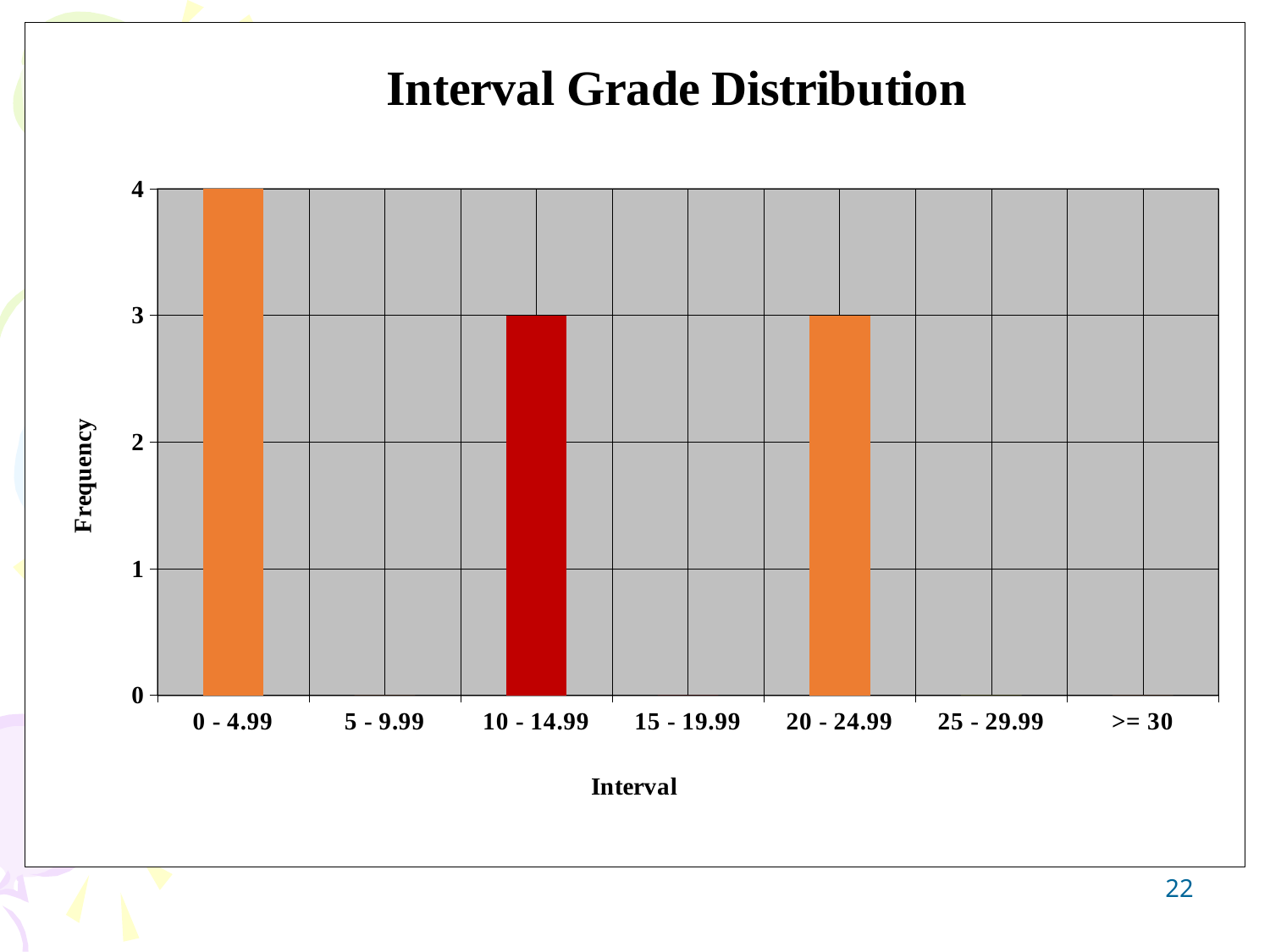
What is the label of the y axis? Frequency What is the difference in frequency between the 0 - 4.99 interval and the 10 - 14.99 interval? 1 What is the frequency for the 0 - 4.99 interval? 4 What is the title of the chart? Interval Grade Distribution What is the frequency for the 10 - 14.99 interval? 3 Which interval has the highest frequency? 0 - 4.99 Is the frequency for the 10 - 14.99 interval greater or less than 2? greater How many intervals are shown on the x axis? 7 What kind of chart is shown on the slide? bar chart What is the frequency for the 20 - 24.99 interval? 3 Which has a higher frequency, the 0 - 4.99 interval or the 20 - 24.99 interval? 0 - 4.99 How many intervals have a visible bar? 3